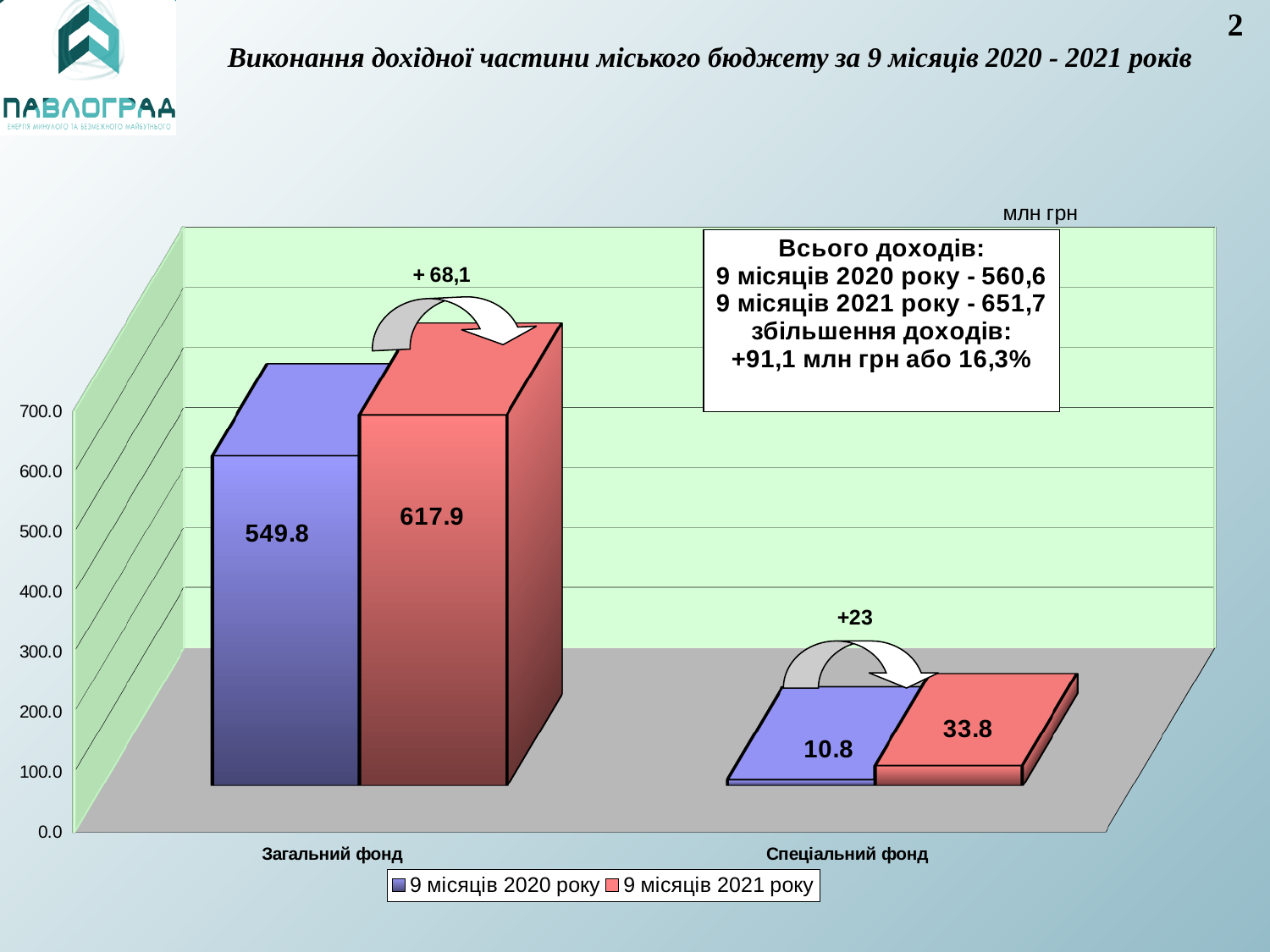
What is the value for Спеціальний фонд in the 9 місяців 2020 року series? 10.8 What is the difference between the 9 місяців 2021 року and 9 місяців 2020 року values for Загальний фонд? 68.1 What is the value for Загальний фонд in the 9 місяців 2021 року series? 617.9 What is the value for Спеціальний фонд in the 9 місяців 2021 року series? 33.8 Which is larger for Спеціальний фонд: the 9 місяців 2020 року value or the 9 місяців 2021 року value? 9 місяців 2021 року Which category has the lowest value in the 9 місяців 2020 року series? Спеціальний фонд How many series does the chart legend list? 2 What kind of chart is shown on the slide? Bar chart Which category has the highest value in the 9 місяців 2021 року series? Загальний фонд How many categories are shown on the x axis of the chart? 2 What is the value for Загальний фонд in the 9 місяців 2020 року series? 549.8 What is the difference between the 9 місяців 2021 року and 9 місяців 2020 року values for Спеціальний фонд? 23